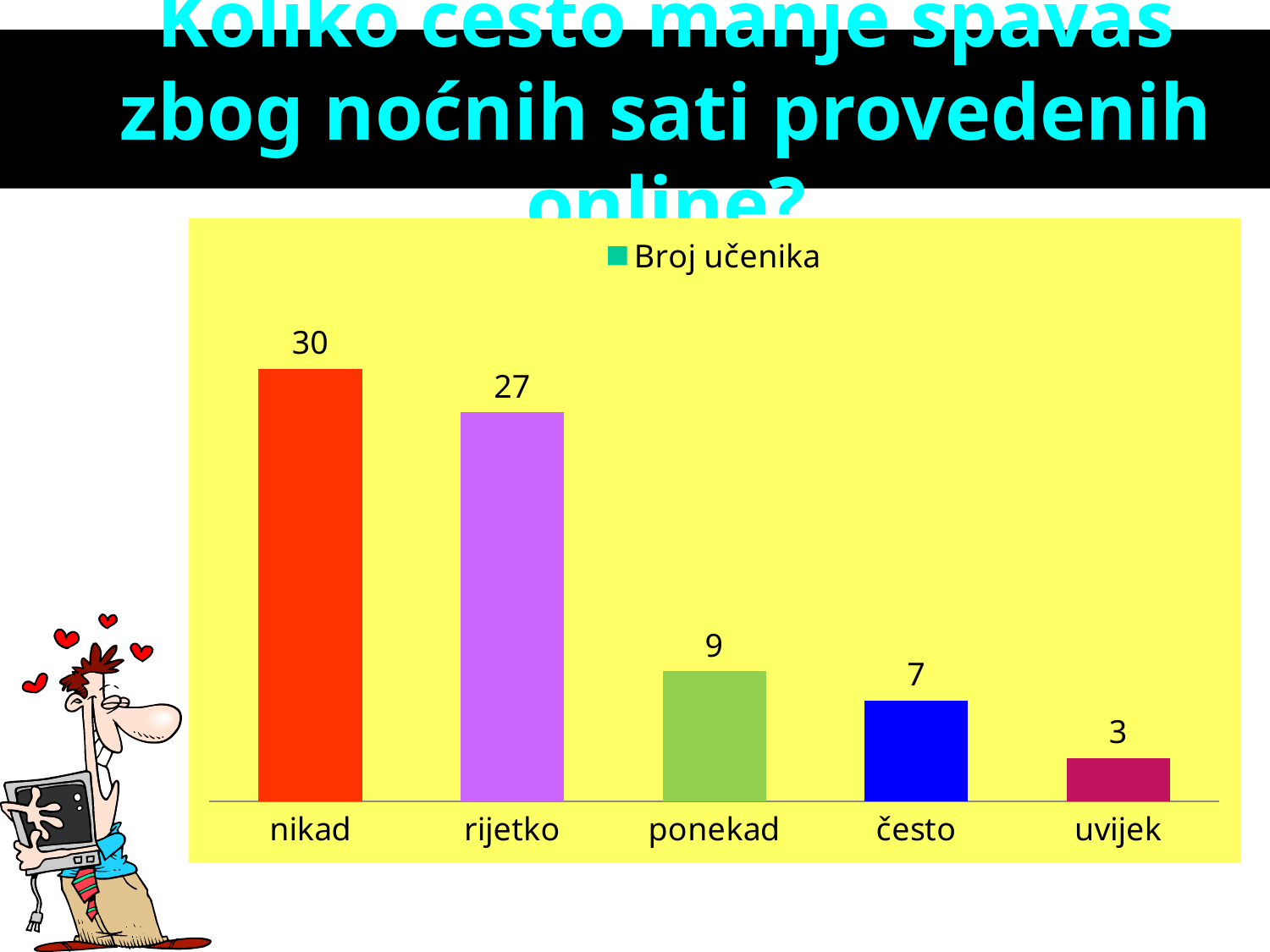
What is the difference between the values for "nikad" and "rijetko"? 3 What is the value for "rijetko"? 27 Which category has the lowest value? uvijek What is the value for "ponekad"? 9 What is the difference between the values for "ponekad" and "često"? 2 What is the value for "uvijek"? 3 How many categories are shown on the x axis? 5 Which is larger, the value for "često" or the value for "uvijek"? često What series name does the legend show? Broj učenika What is the value for "nikad"? 30 What kind of chart is shown on the slide? bar chart Which category has the highest value? nikad